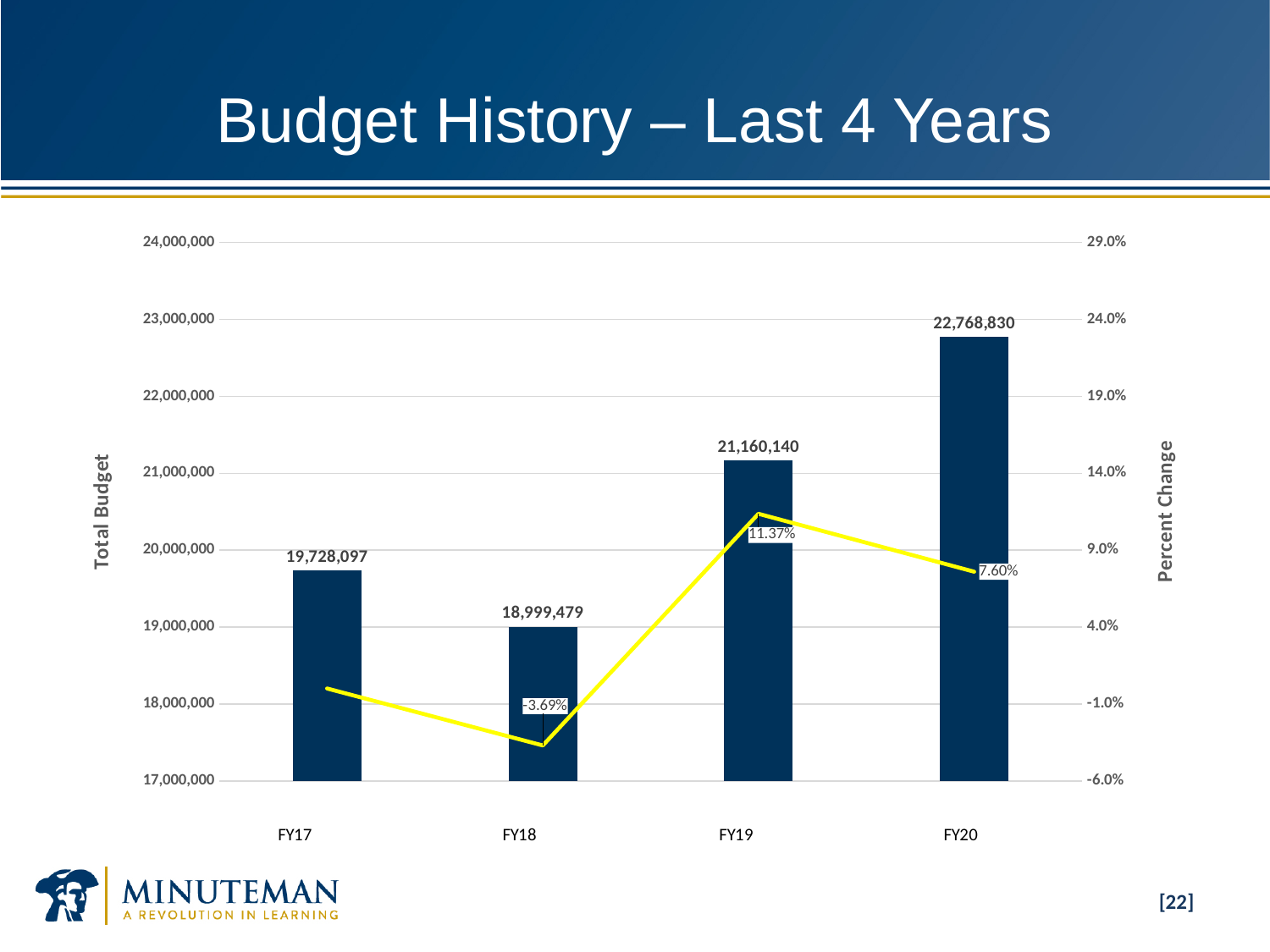
Which fiscal year has the highest total budget? FY20 What is the total budget for FY20? 22,768,830 Does the total budget rise or fall from FY18 to FY20? rise What is the difference between the FY20 and FY19 total budgets? 1,608,690 What is the percent change shown for FY19? 11.37% What is the difference between the FY17 and FY18 total budgets? 728,618 How many fiscal years are shown on the x axis? 4 What is the total budget for FY18? 18,999,479 Which fiscal year has the lowest total budget? FY18 What is the title of the left vertical axis? Total Budget What is the percent change shown for FY18? -3.69% Which is larger, the percent change for FY19 or for FY20? FY19